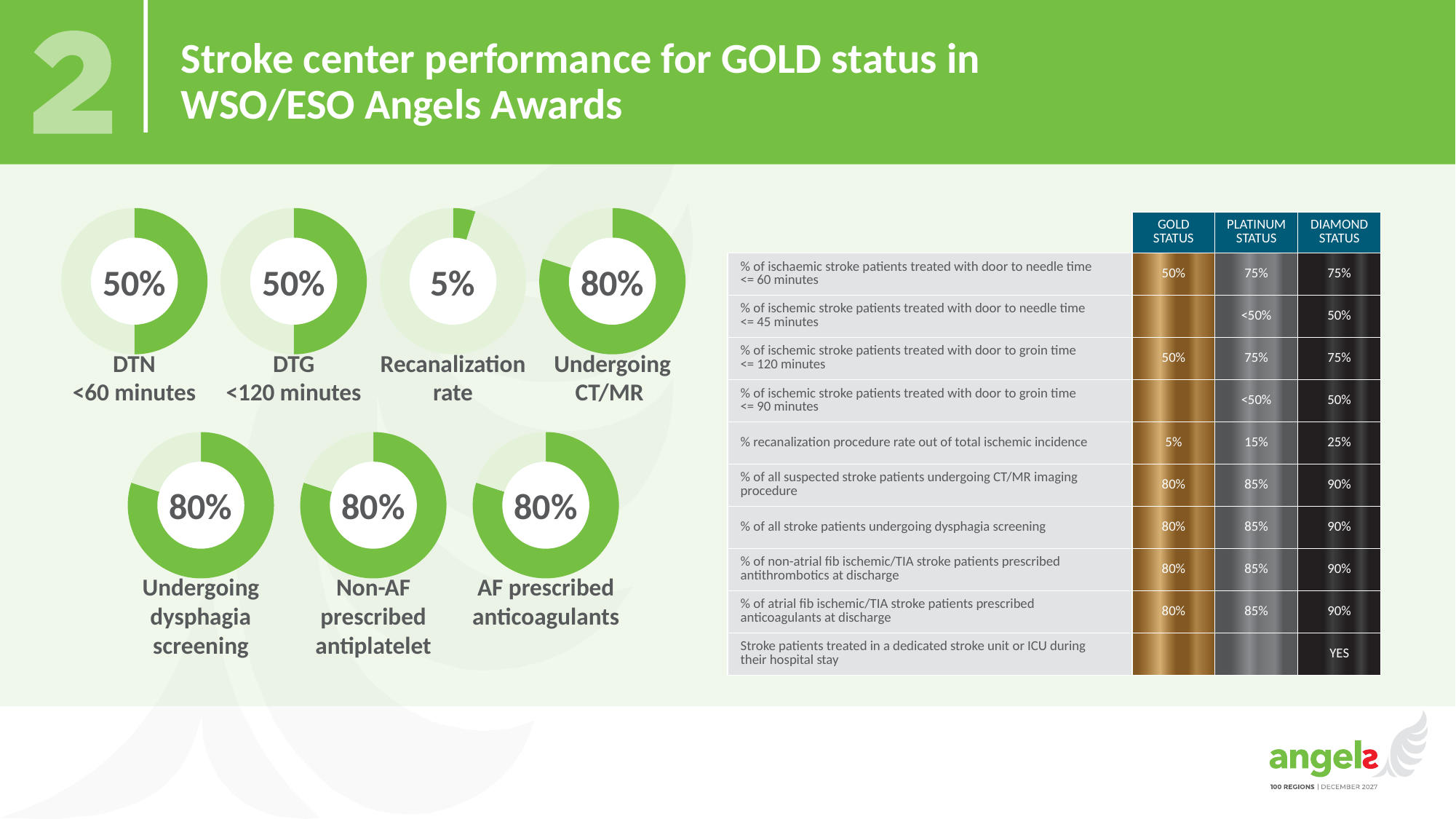
Which is larger, the value for "DTN <60 minutes" or the value for "Undergoing dysphagia screening"? Undergoing dysphagia screening What value is shown in the donut chart labelled "Recanalization rate"? 5% What kind of chart is used to show the GOLD status performance values on the left of the slide? Donut chart Which of the donut charts shows the lowest value? Recanalization rate What value is shown in the donut chart labelled "Undergoing CT/MR"? 80% What is the difference between the value for "Undergoing CT/MR" and the value for "Recanalization rate"? 75% What value is shown in the donut chart labelled "DTN <60 minutes"? 50% What colour is the filled portion of the donut charts? Green What value is shown in the donut chart labelled "DTG <120 minutes"? 50% How many donut charts are shown on the slide? 7 What value is shown in the donut chart labelled "AF prescribed anticoagulants"? 80% How many of the donut charts show a value of 80%? 4